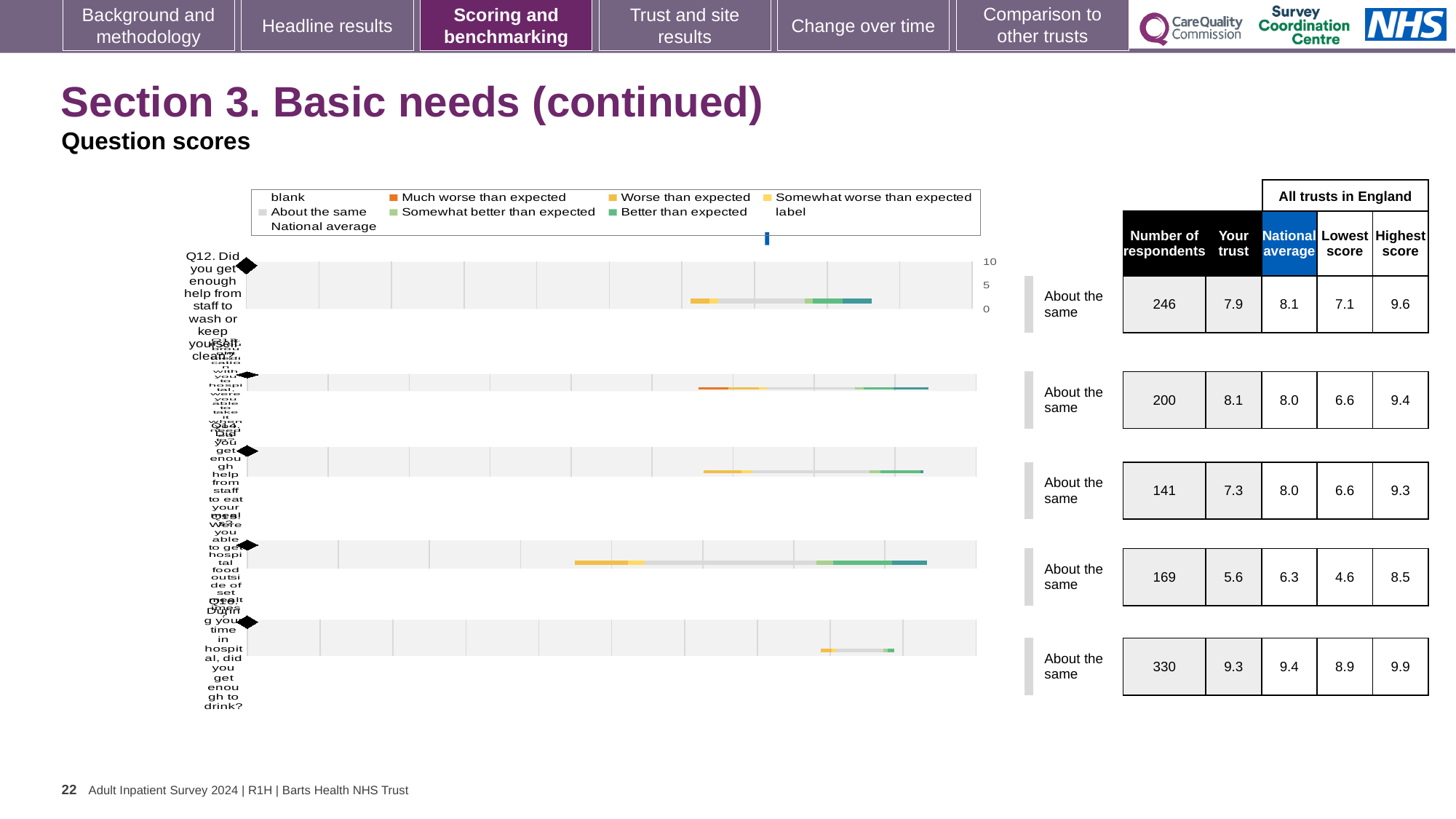
Which question row has the lowest 'Your trust' score? The fourth row (5.6) What is the 'Your trust' score for the fourth question row in the table? 5.6 What is the number of respondents for Q12 (help from staff to wash or keep yourself clean)? 246 What is the lowest score across all trusts in England for the fifth question row? 8.9 What kind of chart is shown on the slide? bar chart What is the national average score for Q12? 8.1 For Q12, which is larger: the 'Your trust' score or the national average? National average How many questions (bars) are plotted in the chart? 5 What benchmark category is shown for all five questions on the slide? About the same What is the 'Your trust' score for Q12? 7.9 For Q12, what is the difference between the highest score and the lowest score across all trusts in England? 2.5 Which question row has the highest number of respondents? The fifth row (330)